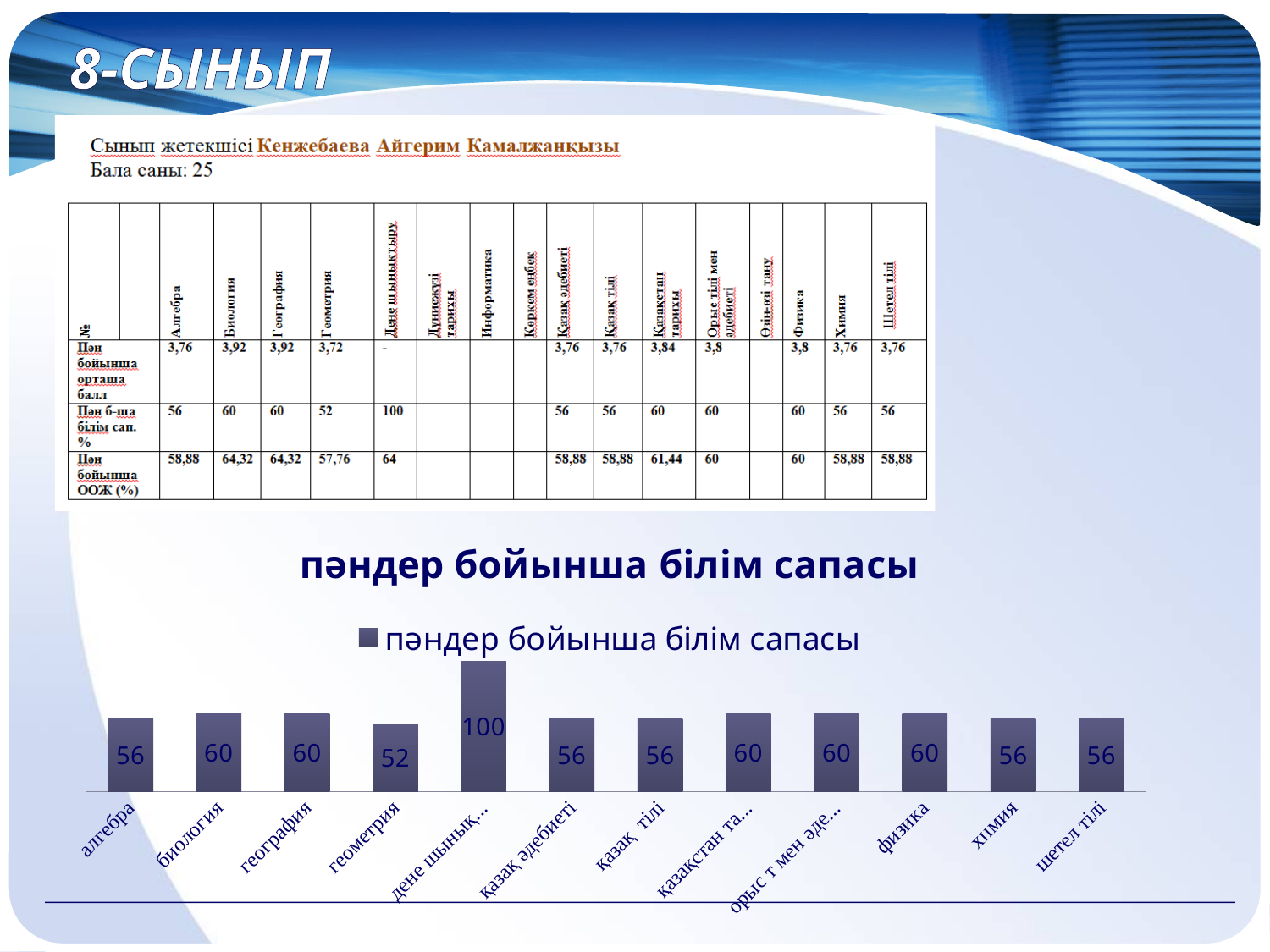
What type of chart is shown on the slide? bar chart What is the difference between the values for биология and химия? 4 Which category has the highest value in the chart? дене шынық... How many series does the chart legend list? 1 What is the value for шетел тілі in the chart? 56 How many categories are shown on the x axis of the chart? 12 What is the value for геометрия in the chart? 52 Which is larger, the value for география or the value for қазақ тілі? география Which category has the lowest value in the chart? геометрия What is the value for алгебра in the chart? 56 What is the value for физика in the chart? 60 What is the difference between the values for дене шынық... and геометрия? 48